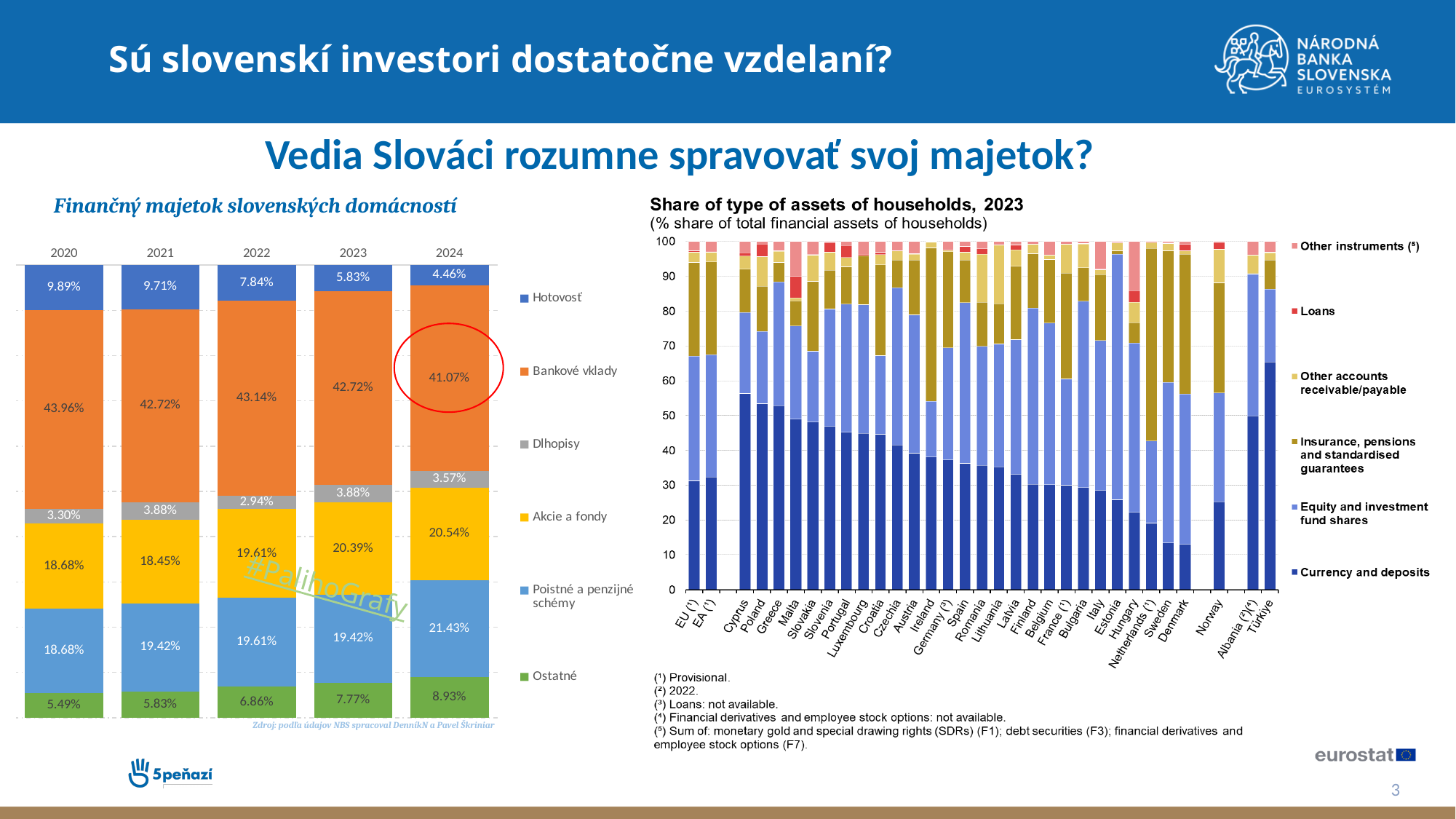
In the chart 'Finančný majetok slovenských domácností', does Hotovosť rise or fall from 2020 to 2024? fall How many years are shown in the chart 'Finančný majetok slovenských domácností'? 5 In the chart 'Finančný majetok slovenských domácností', in which year is Hotovosť highest? 2020 In the chart 'Finančný majetok slovenských domácností', what is the difference between Bankové vklady in 2020 and in 2024? 2.89% In the chart 'Share of type of assets of households, 2023', is the value for Currency and deposits for Türkiye greater or less than 60? greater What kind of chart is 'Share of type of assets of households, 2023'? stacked bar chart In the chart 'Finančný majetok slovenských domácností', what is the value for Bankové vklady in 2024? 41.07% In the chart 'Finančný majetok slovenských domácností', in which year is Dlhopisy lowest? 2022 In the chart 'Finančný majetok slovenských domácností', what is the value for Ostatné in 2020? 5.49% In the chart 'Finančný majetok slovenských domácností', what is the value for Akcie a fondy in 2023? 20.39% In the chart 'Finančný majetok slovenských domácností', which is larger in 2024: Poistné a penzijné schémy or Akcie a fondy? Poistné a penzijné schémy How many series does the legend of the chart 'Finančný majetok slovenských domácností' list? 6